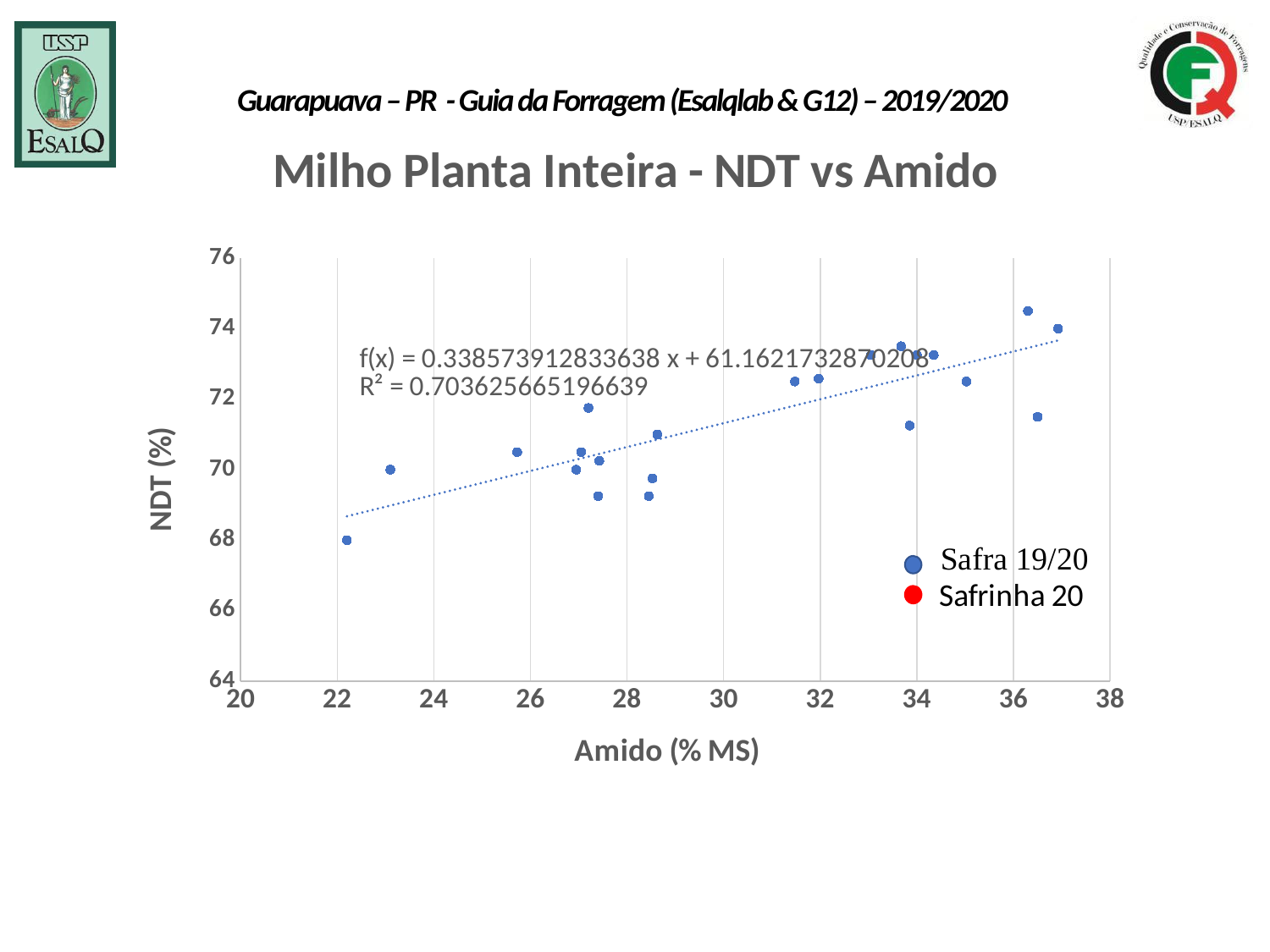
Is the NDT value of the leftmost point (near 22% Amido) greater or less than 70? less Does NDT (%) generally rise or fall as Amido (% MS) increases along the x axis? Rise What is the R² value printed on the chart? 0.703625665196639 Is the NDT value of the point near 23% Amido greater or less than 72? less Is the NDT value of the highest point (near 36% Amido) greater or less than 74? greater What are the two series named in the legend? Safra 19/20 and Safrinha 20 What is the title of the chart? Milho Planta Inteira - NDT vs Amido What is the trendline equation printed on the chart? f(x) = 0.338573912833638 x + 61.1621732870208 How many series does the chart legend list? 2 What kind of chart is shown on the slide? Scatter chart